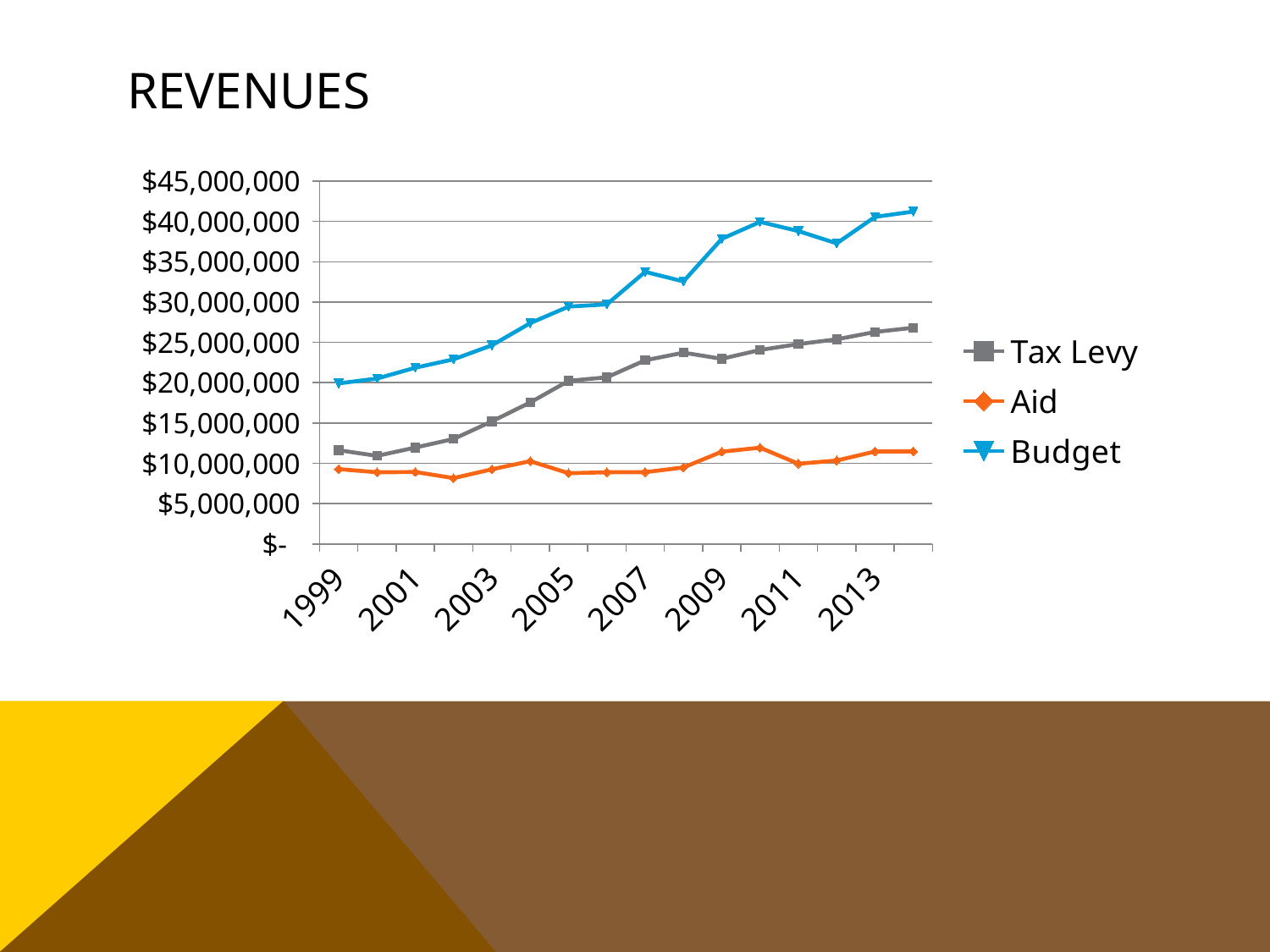
Is the Tax Levy value for 1999 greater or less than $10,000,000? greater Is the Tax Levy value for 2013 greater or less than $25,000,000? greater Is the Aid value for 2002 greater or less than $10,000,000? less How many series does the legend list? 3 Does the Tax Levy series generally rise or fall from 1999 to the end of the chart? rise In which year is the Aid series at its lowest? 2002 Which series has the lowest values across the whole chart? Aid In 2007, which is larger, Tax Levy or Aid? Tax Levy Which series has the highest values across the whole chart? Budget What kind of chart is shown on the slide? line chart What is the title of the slide containing the chart? REVENUES